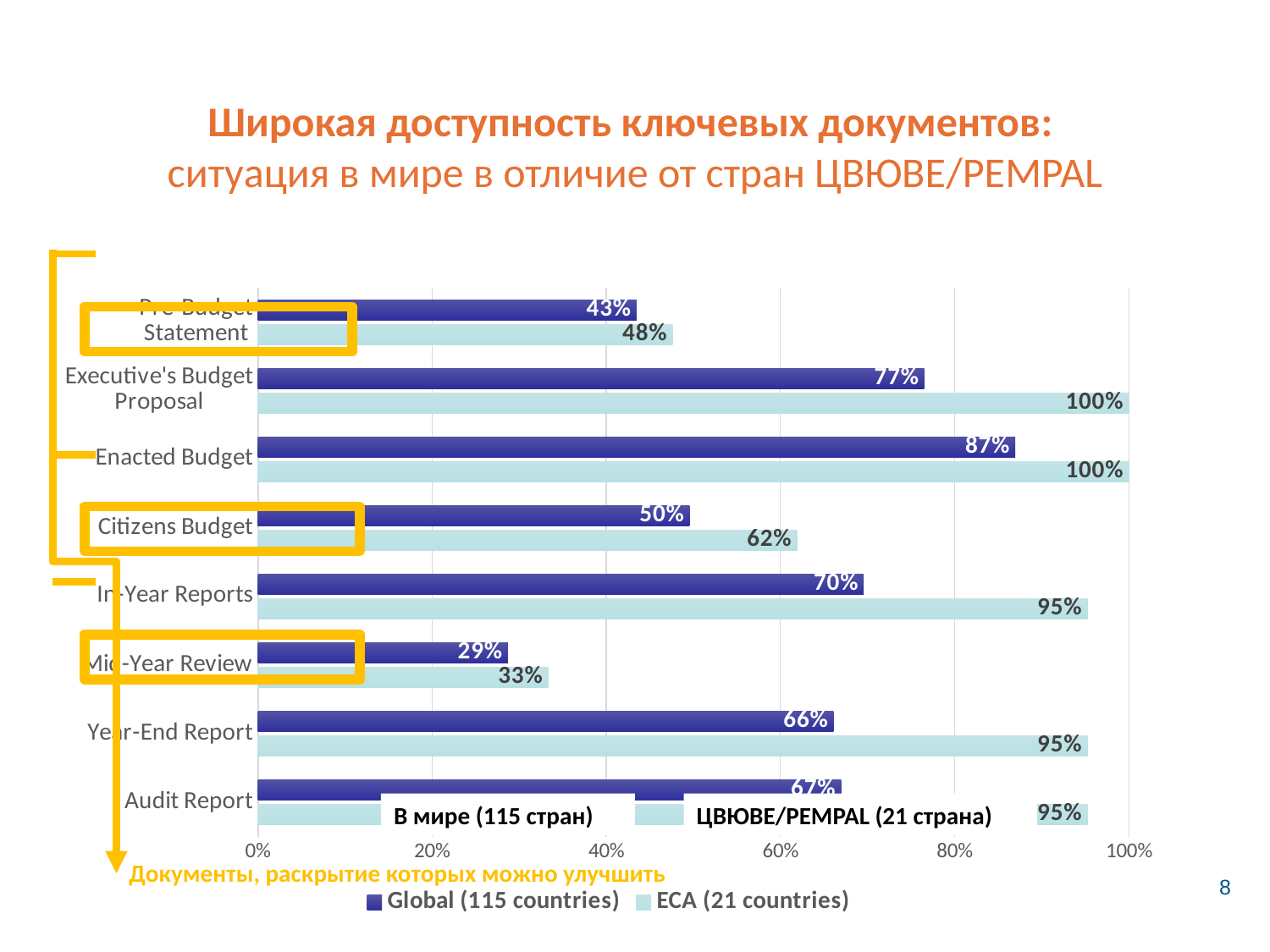
How many document categories are shown on the chart? 8 Which document has the lowest Global (115 countries) value? Mid-Year Review Which document has the highest Global (115 countries) value? Enacted Budget What is the ECA (21 countries) value for Citizens Budget? 62% What is the Global (115 countries) value for Mid-Year Review? 29% How many series does the chart legend list? 2 What is the difference between the ECA (21 countries) and Global (115 countries) values for Executive's Budget Proposal? 23% What type of chart is shown on the slide? Bar chart Is the Global (115 countries) value for Pre-Budget Statement greater or less than 40%? greater Which is larger for Audit Report: the Global (115 countries) value or the ECA (21 countries) value? ECA (21 countries) What is the Global (115 countries) value for Enacted Budget? 87% What is the ECA (21 countries) value for In-Year Reports? 95%